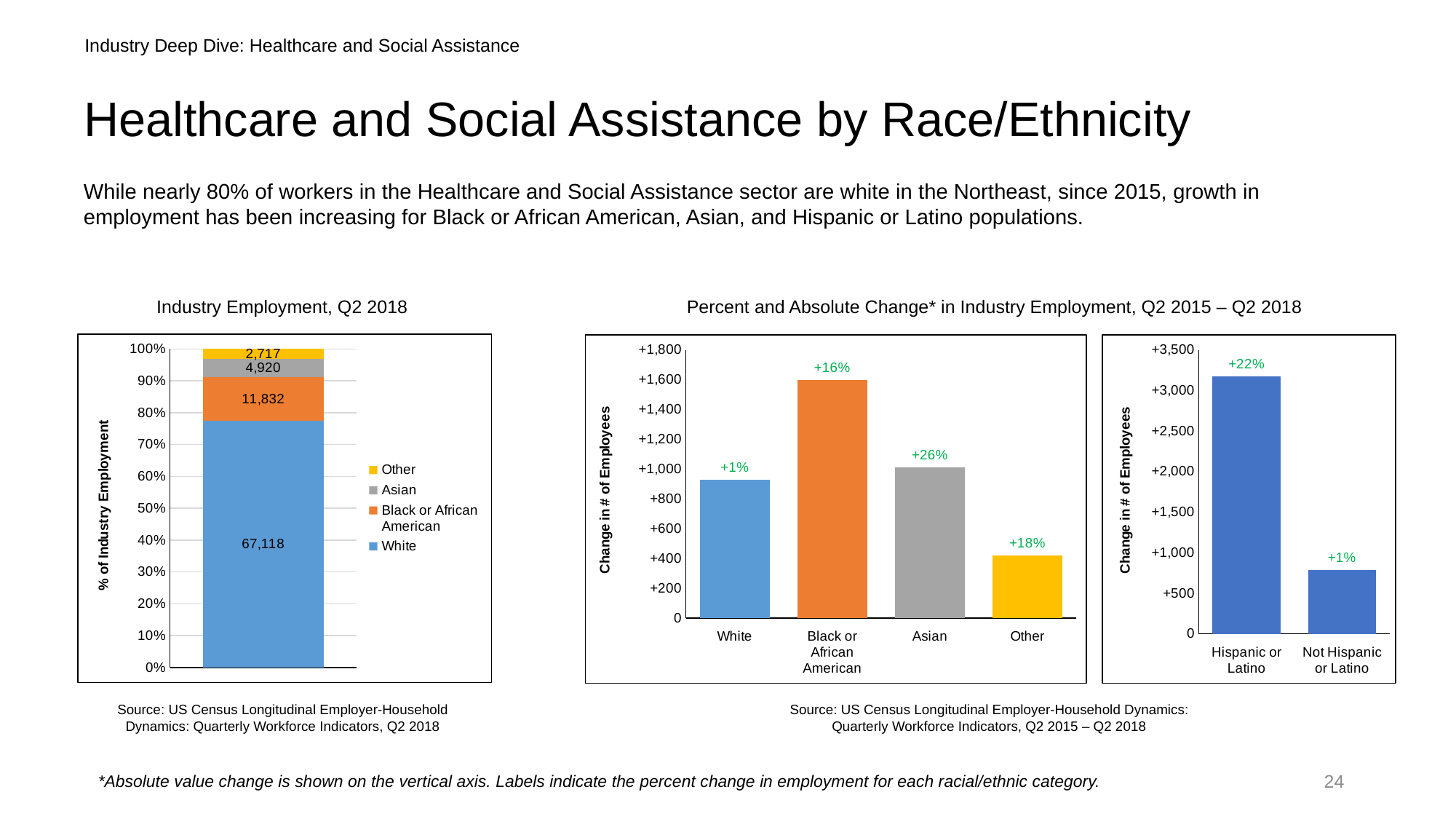
In the middle chart (Percent and Absolute Change in Industry Employment), what percent change label is shown for Asian? +26% In the Industry Employment, Q2 2018 chart, what is the difference between the Black or African American value and the Other value? 9,115 In the Industry Employment, Q2 2018 chart, what is the value for Asian? 4,920 In the middle chart (Percent and Absolute Change in Industry Employment), which category has the lowest change in number of employees? Other In the Industry Employment, Q2 2018 chart, what is the value for White? 67,118 What kind of chart is the Industry Employment, Q2 2018 chart? Stacked bar chart In the Industry Employment, Q2 2018 chart, how many series does the legend list? 4 In the middle chart (Percent and Absolute Change in Industry Employment), is the value for White greater or less than +1,000? less In the right chart (change in employment for Hispanic or Latino and Not Hispanic or Latino), is the value for Not Hispanic or Latino greater or less than +1,000? less In the Industry Employment, Q2 2018 chart, what is the total of the stacked bar? 86,587 In the middle chart (Percent and Absolute Change in Industry Employment), which category has the highest change in number of employees? Black or African American In the right chart (change in employment for Hispanic or Latino and Not Hispanic or Latino), what percent change label is shown for Hispanic or Latino? +22%